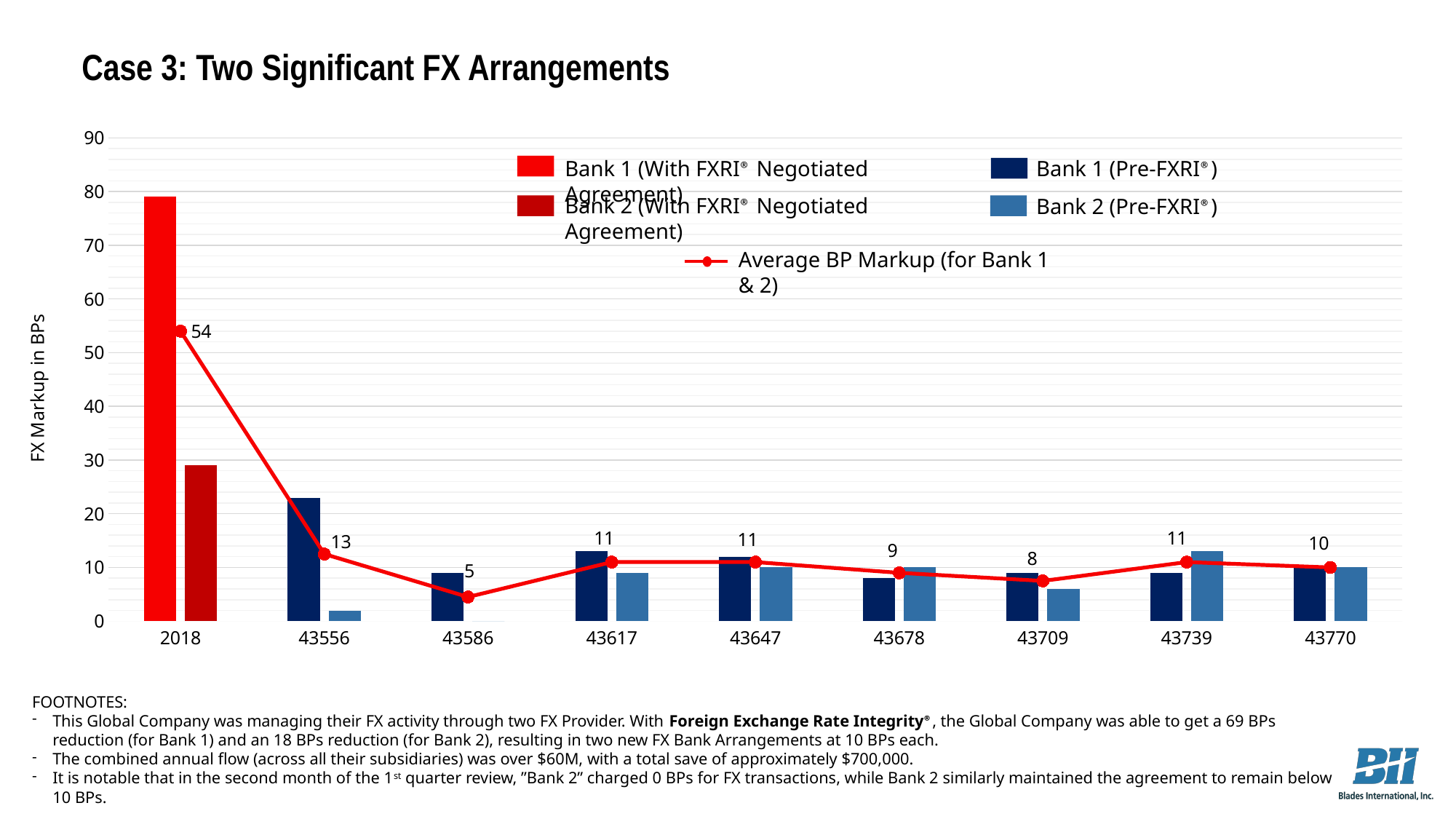
What is the difference between the Average BP Markup at 2018 and at 43556? 41 Which has the larger Average BP Markup, 43678 or 43709? 43678 What is the Average BP Markup (for Bank 1 & 2) at 2018? 54 Is the value of the Bank 1 (With FXRI Negotiated Agreement) bar at 2018 greater or less than 70? greater How many series does the legend list? 5 What is the title of the vertical axis? FX Markup in BPs At which x-axis category is the Average BP Markup (for Bank 1 & 2) highest? 2018 What is the Average BP Markup (for Bank 1 & 2) at 43739? 11 Is the value of the Bank 2 (With FXRI Negotiated Agreement) bar at 2018 greater or less than 40? less How many categories are shown on the x axis? 9 What is the Average BP Markup (for Bank 1 & 2) at 43586? 5 At which x-axis category is the Average BP Markup (for Bank 1 & 2) lowest? 43586